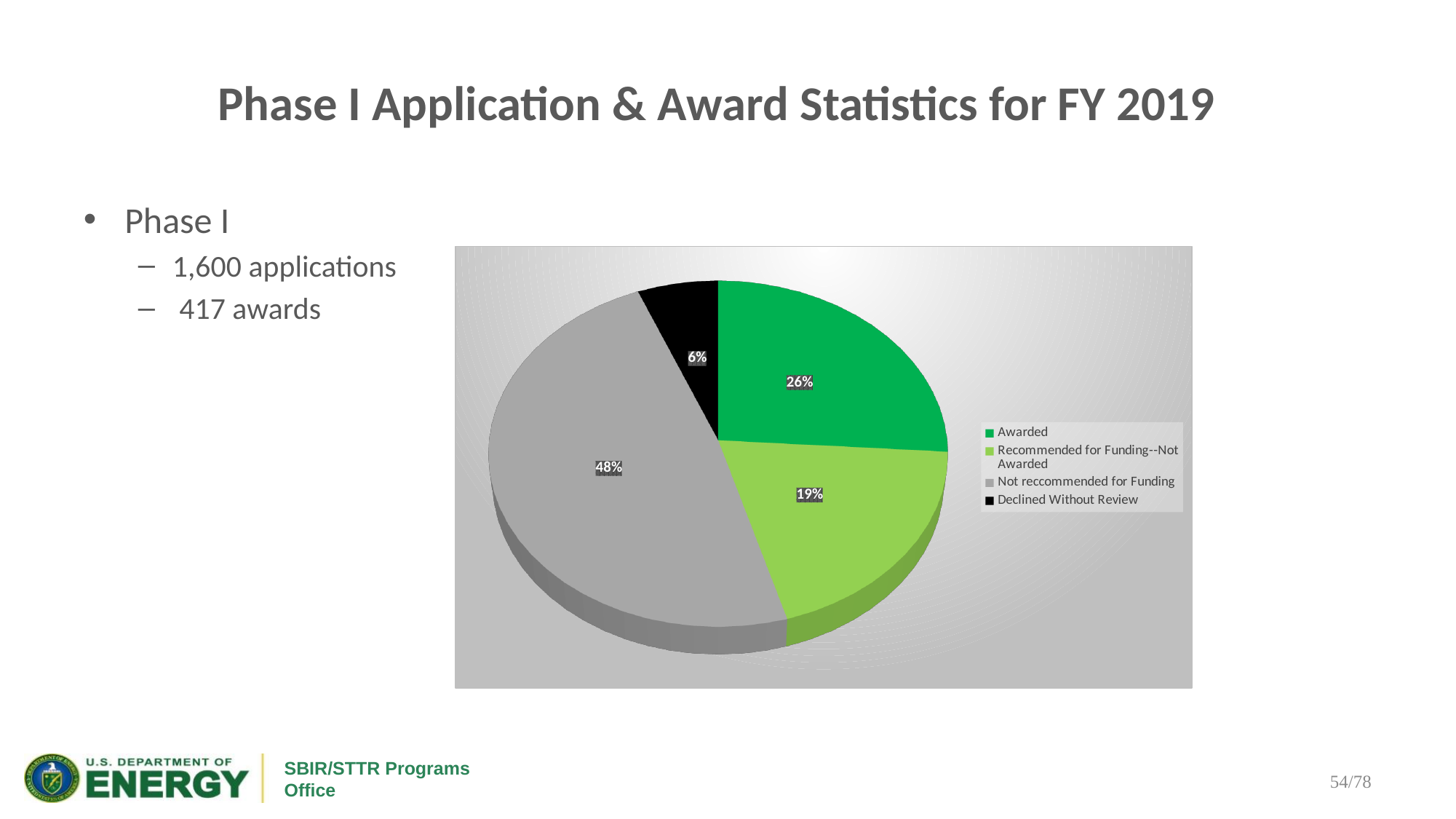
What colour is the Declined Without Review slice? Black What share of the pie is labelled Declined Without Review? 6% Which category has the largest slice of the pie? Not reccommended for Funding How many slices does the pie chart have? 4 Which slice is larger, Awarded or Recommended for Funding--Not Awarded? Awarded What is the difference in percentage points between the Not reccommended for Funding slice and the Awarded slice? 22 What share of the pie is labelled Not reccommended for Funding? 48% Which category has the smallest slice of the pie? Declined Without Review What share of the pie is labelled Awarded? 26% What share of the pie is labelled Recommended for Funding--Not Awarded? 19% What is the combined share of the Awarded and Recommended for Funding--Not Awarded slices? 45% What kind of chart is shown on the slide? Pie chart